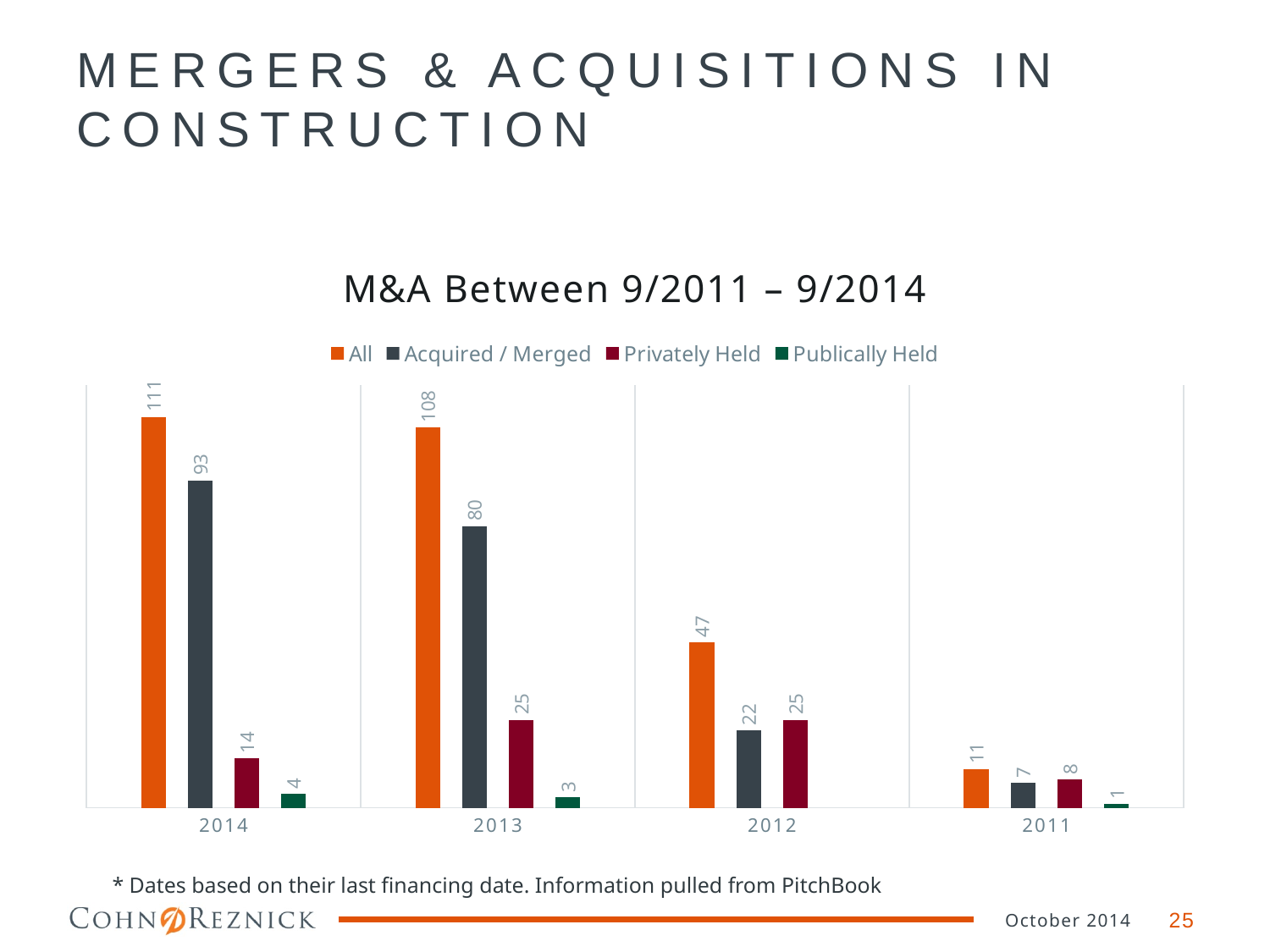
What is the Publically Held value for 2011? 1 What is the difference between the All values for 2014 and 2013? 3 What is the Acquired / Merged value for 2013? 80 What is the Privately Held value for 2012? 25 How many years are shown on the x axis? 4 How many series does the legend list? 4 What is the value of the All series for 2014? 111 Which year has the highest value for the All series? 2014 In 2012, which is larger: Acquired / Merged or Privately Held? Privately Held Do the All values rise or fall moving from 2014 to 2011 along the x axis? Fall Which year has the lowest value for the All series? 2011 What type of chart is shown on the slide? Bar chart